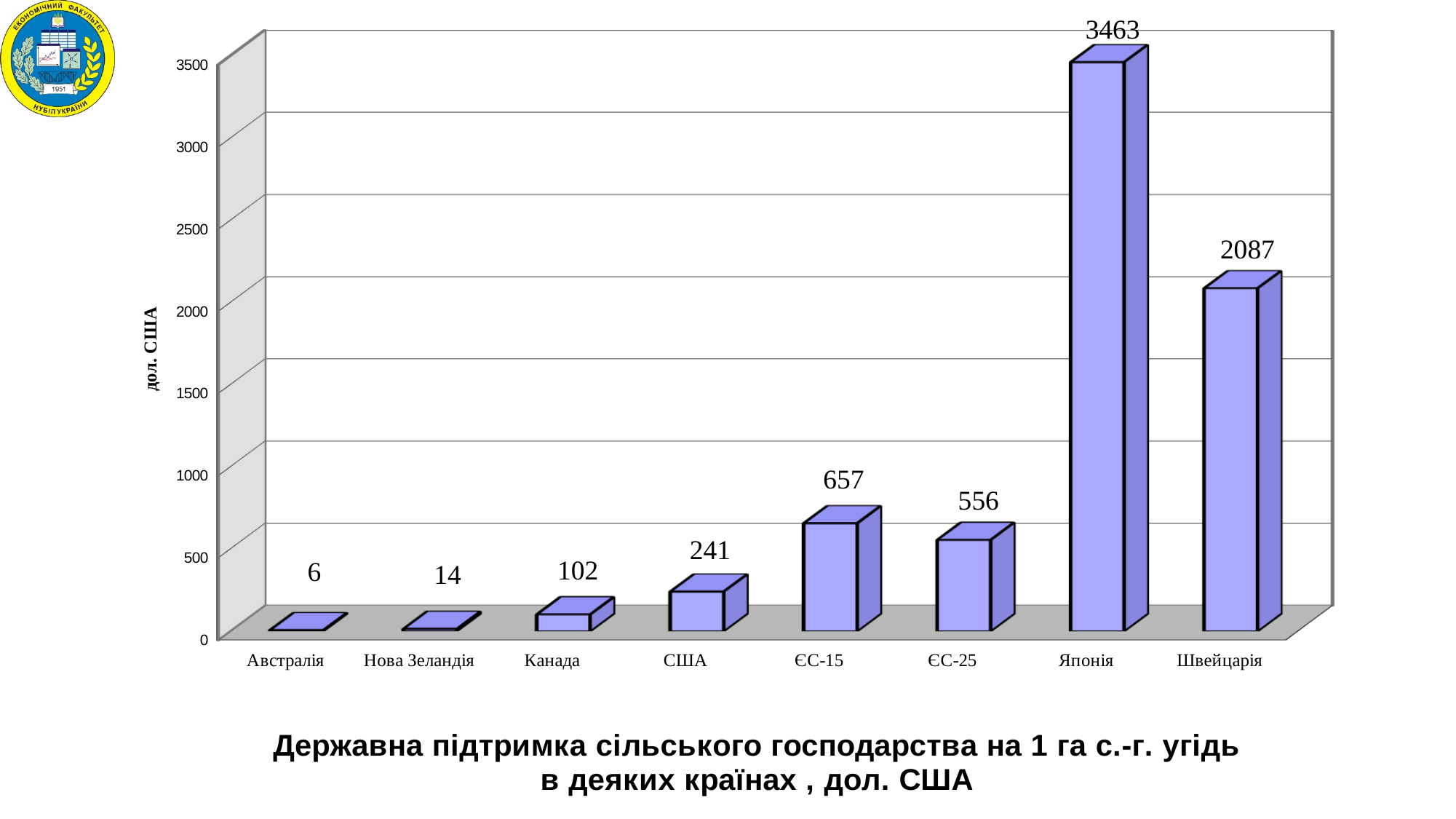
What is the difference between the values for ЄС-15 and ЄС-25? 101 What is the value for Канада? 102 Is the value for Швейцарія greater or less than 2000? greater Which is larger, the value for США or the value for Канада? США How many countries are shown on the x axis? 8 Which country has the lowest value? Австралія What is the difference between the values for Японія and Швейцарія? 1376 What is the value for ЄС-25? 556 What kind of chart is shown on the slide? bar chart Which country has the highest value? Японія What is the label on the vertical axis? дол. США What is the value for Японія? 3463